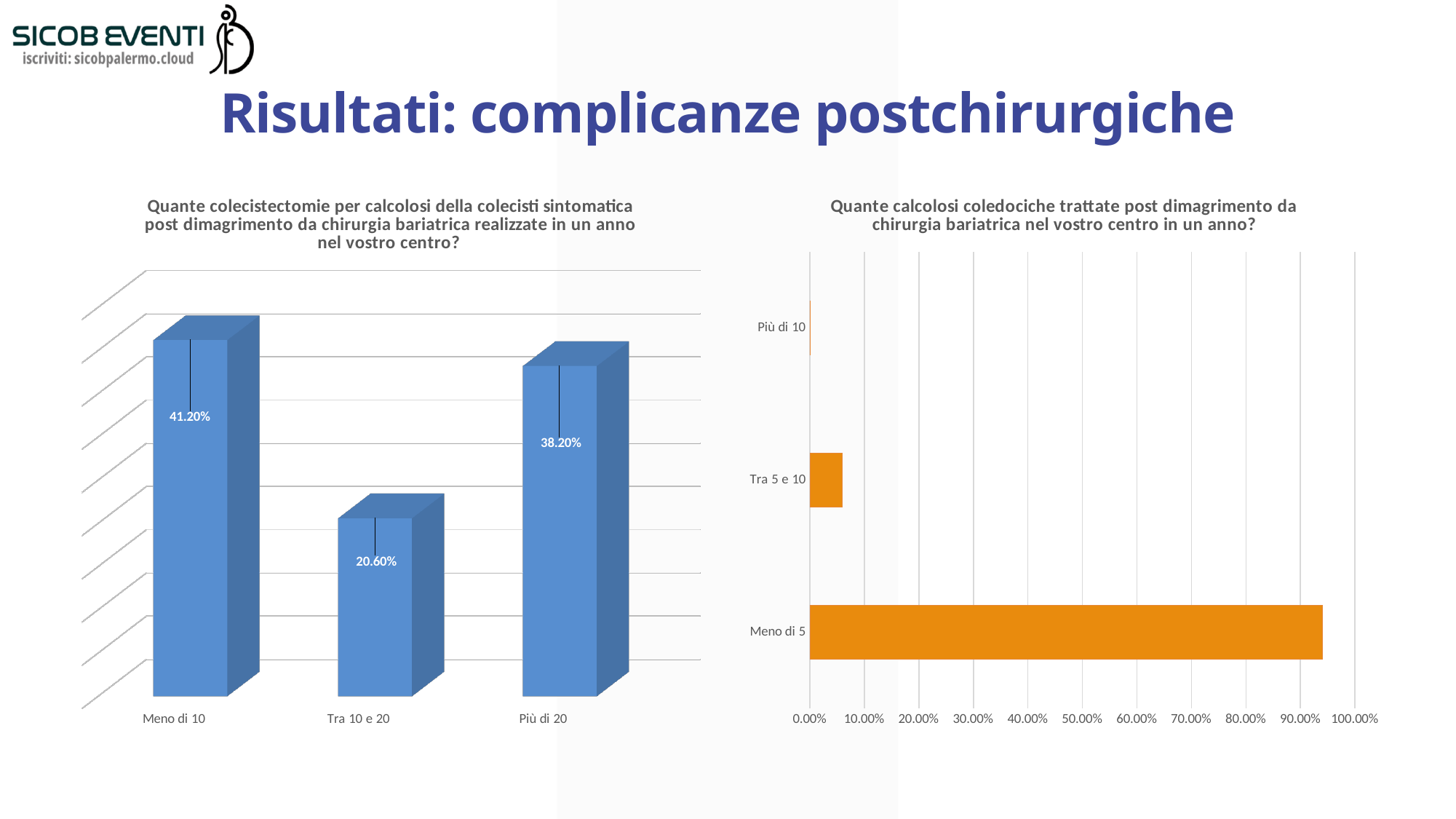
In the left chart, which category has the lowest value? Tra 10 e 20 In the right chart, is the value for 'Meno di 5' greater or less than 90.00%? greater In the left chart, which category has the highest value? Meno di 10 In the left chart, what is the value for 'Meno di 10'? 41.20% In the right chart, is the value for 'Tra 5 e 10' greater or less than 10.00%? less In the left chart, what is the difference between the values for 'Meno di 10' and 'Tra 10 e 20'? 20.60% In the right chart, how many categories are listed on the vertical axis? 3 In the left chart, how many categories are shown on the x axis? 3 What kind of chart is the right chart? Bar chart In the left chart, what is the value for 'Tra 10 e 20'? 20.60% In the right chart, which category has the highest value? Meno di 5 In the left chart, what is the value for 'Più di 20'? 38.20%